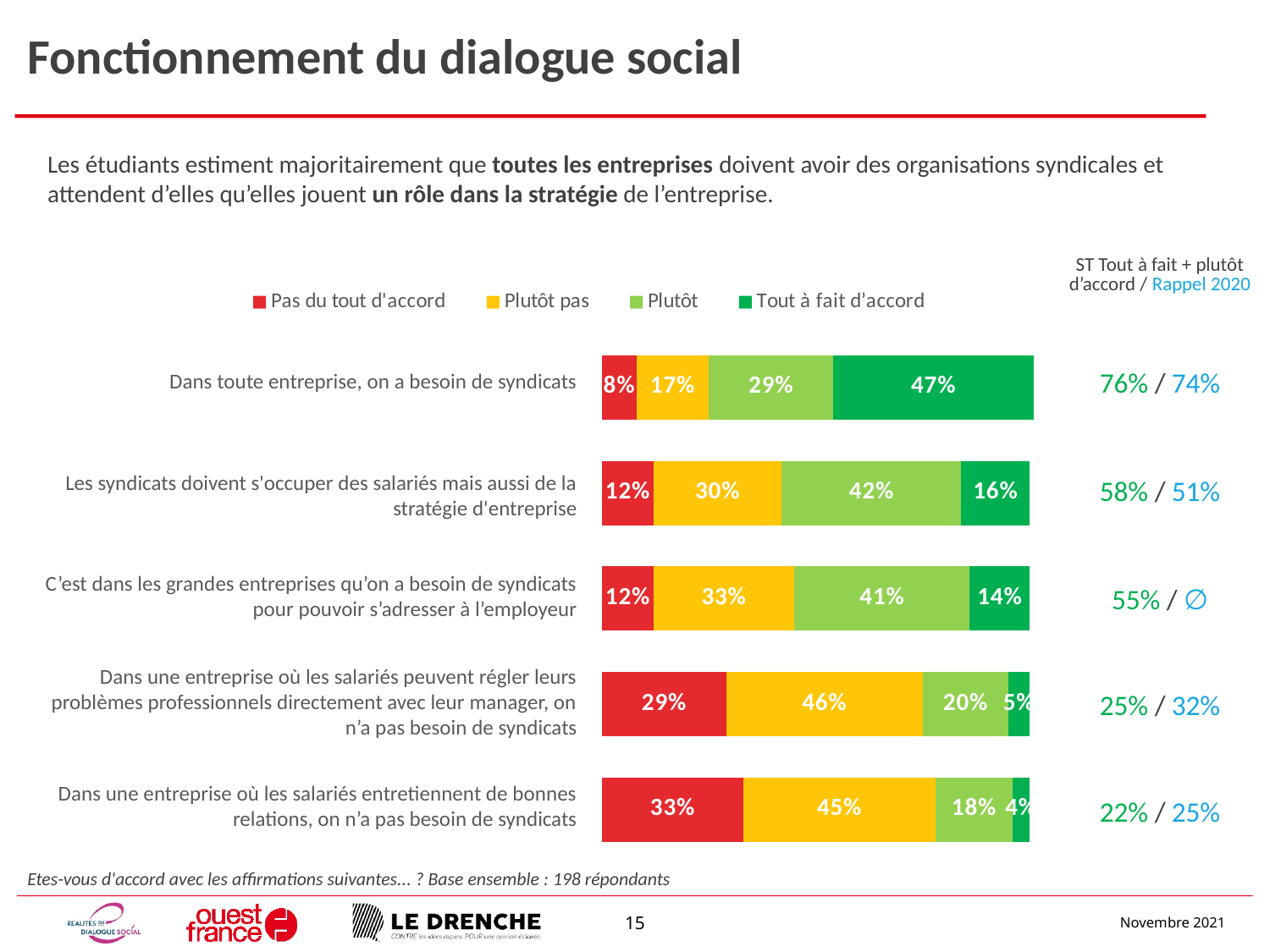
What is the total of the stacked bar for 'Les syndicats doivent s'occuper des salariés mais aussi de la stratégie d'entreprise'? 100% Which statement has the highest 'Tout à fait d'accord' value? Dans toute entreprise, on a besoin de syndicats How many series does the legend list? 4 Which statement has the lowest 'Pas du tout d'accord' value? Dans toute entreprise, on a besoin de syndicats What is the 'Plutôt pas' value for 'Les syndicats doivent s'occuper des salariés mais aussi de la stratégie d'entreprise'? 30% What is the difference between the 'Plutôt' values for 'Les syndicats doivent s'occuper des salariés mais aussi de la stratégie d'entreprise' (42%) and 'Dans une entreprise où les salariés entretiennent de bonnes relations, on n'a pas besoin de syndicats' (18%)? 24% What is the 'Tout à fait d'accord' value for 'Dans toute entreprise, on a besoin de syndicats'? 47% How many statements (categories) are plotted in the chart? 5 Which is larger: the 'Plutôt pas' value for 'Dans une entreprise où les salariés peuvent régler leurs problèmes professionnels directement avec leur manager, on n'a pas besoin de syndicats' or for 'C'est dans les grandes entreprises qu'on a besoin de syndicats pour pouvoir s'adresser à l'employeur'? Dans une entreprise où les salariés peuvent régler leurs problèmes professionnels directement avec leur manager, on n'a pas besoin de syndicats What is the 'Pas du tout d'accord' value for 'Dans une entreprise où les salariés entretiennent de bonnes relations, on n'a pas besoin de syndicats'? 33% What colour represents 'Pas du tout d'accord' in the chart? Red What kind of chart is shown on the slide? Stacked bar chart